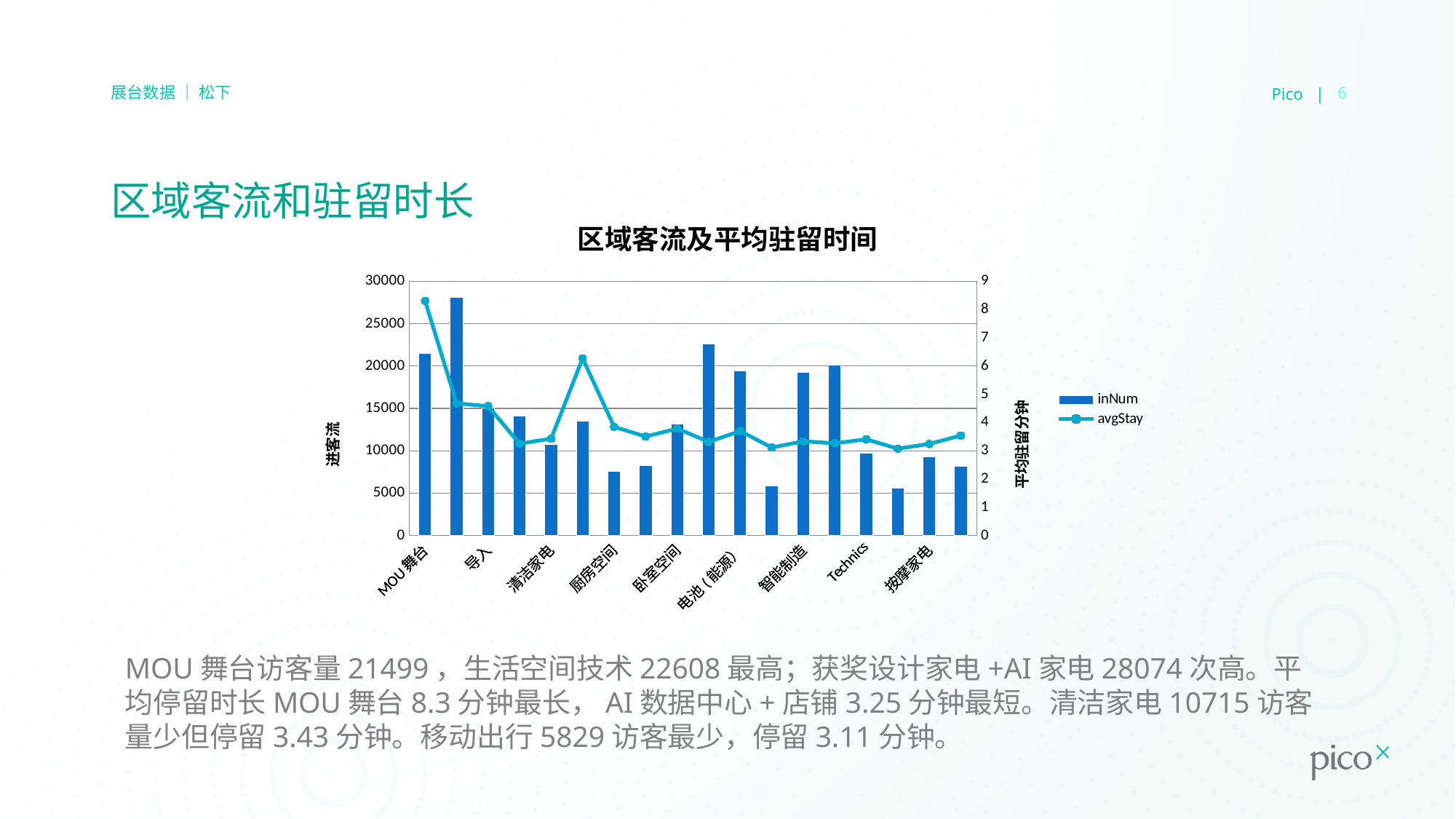
Which labeled category has the highest avgStay value? MOU 舞台 Is the inNum value for 清洁家电 greater or less than 15000? less What is the title of the chart? 区域客流及平均驻留时间 How many series does the chart legend list? 2 Is the inNum value for MOU 舞台 greater or less than 20000? greater Is the avgStay value for MOU 舞台 greater or less than 8? greater What kind of chart is shown? Combined bar and line chart Which has the larger inNum value, 厨房空间 or 卧室空间? 卧室空间 What are the two series named in the legend? inNum and avgStay Which has the larger avgStay value, MOU 舞台 or 导入? MOU 舞台